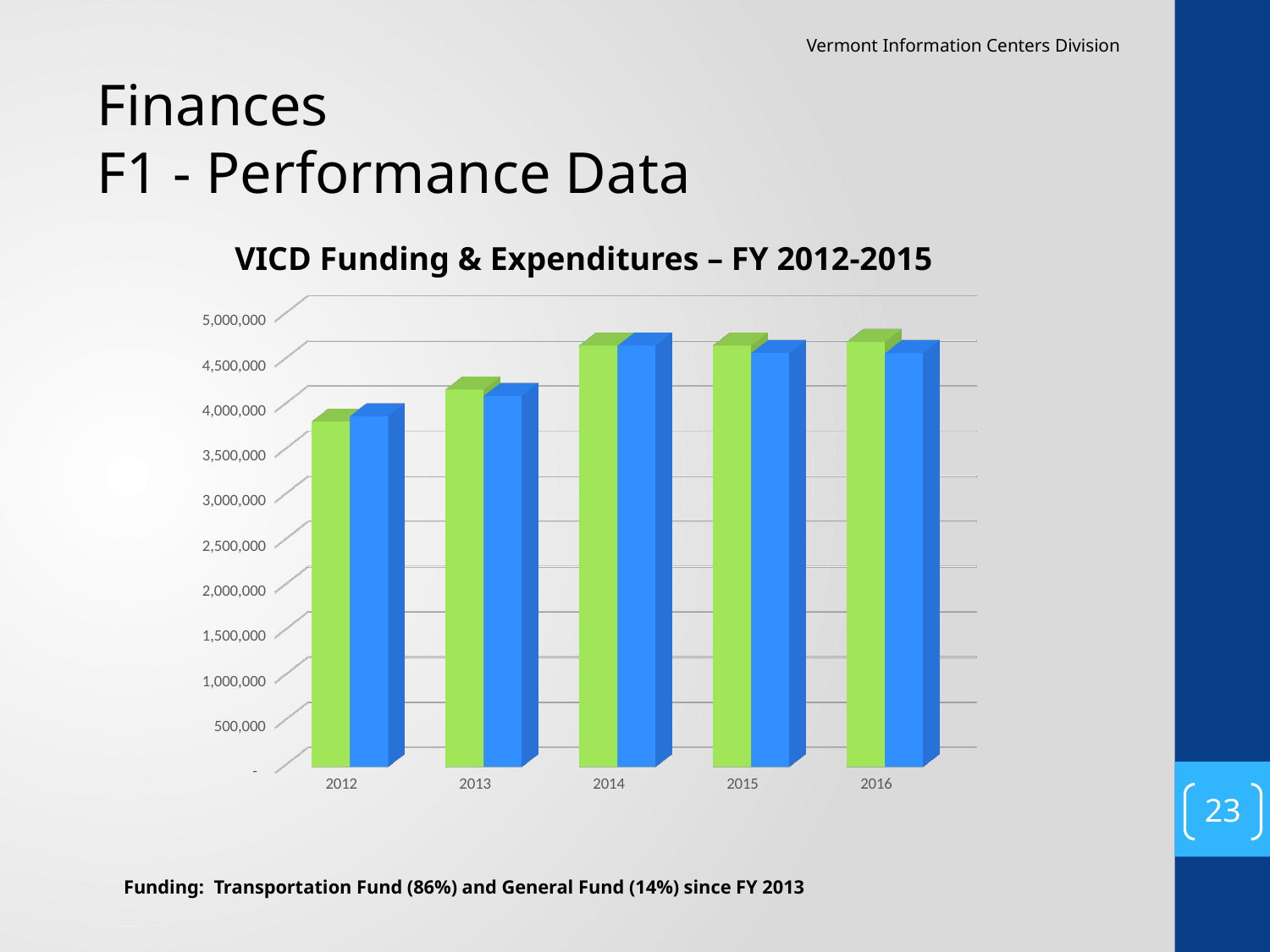
Is the green bar for 2016 greater or less than 4,500,000? greater Is the blue bar for 2014 greater or less than 4,500,000? greater How many bars are plotted for each year in the chart? 2 Which year has the lowest green bar? 2012 Is the green bar for 2012 greater or less than 4,000,000? less What is the title of the chart? VICD Funding & Expenditures – FY 2012-2015 Do the green bars rise or fall from 2012 to 2014? Rise How many years are shown on the x axis of the chart? 5 Which is larger, the green bar for 2012 or the green bar for 2014? 2014 What kind of chart is shown on the slide? Bar chart